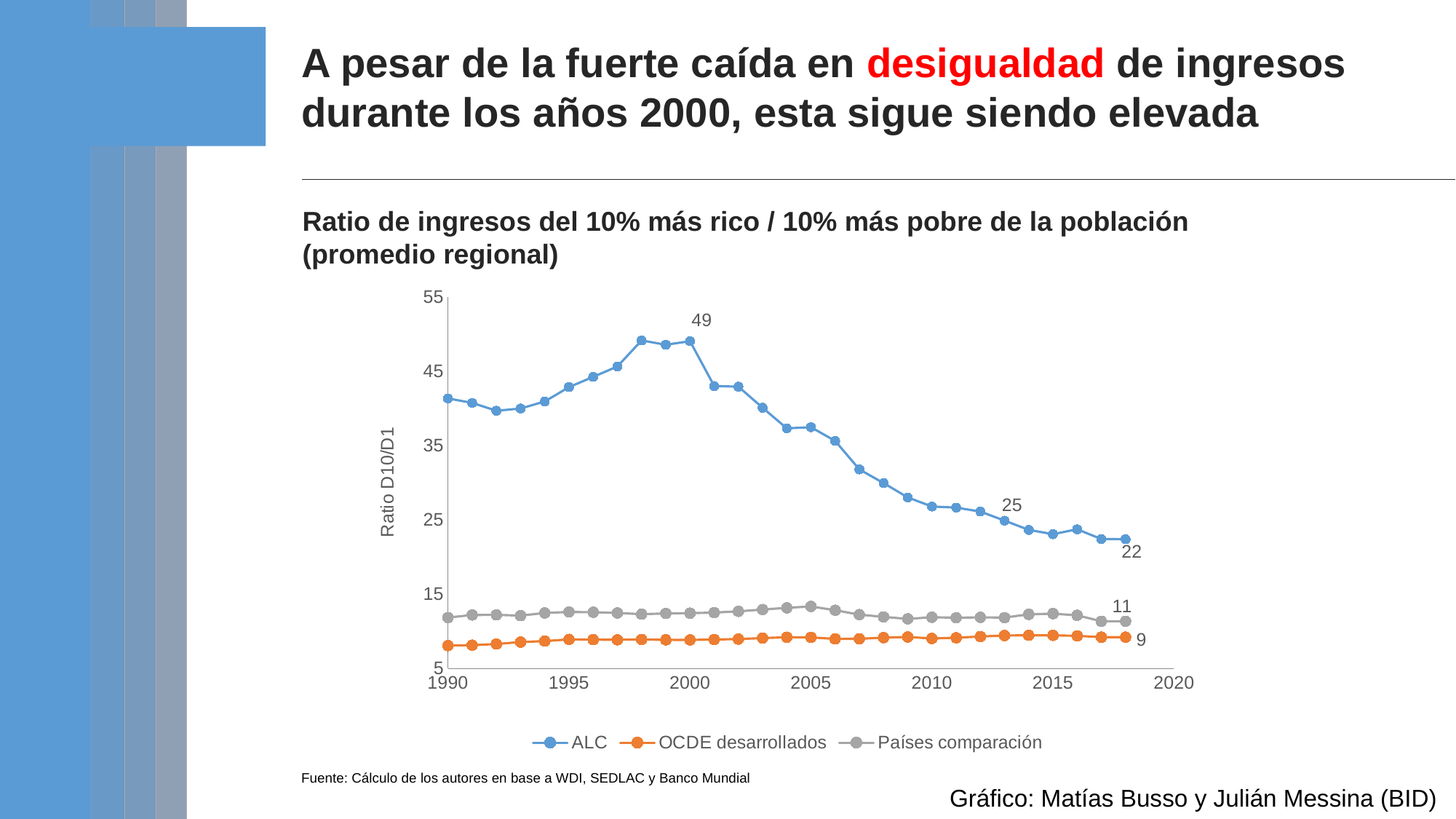
Which series has the highest values throughout the chart? ALC Is the value for ALC in 1990 greater or less than 35? greater What is the value of the OCDE desarrollados series in 2018? 9 What is the difference between the ALC value in 2000 and the ALC value in 2018? 27 What is the value of the Países comparación series in 2018? 11 What is the label of the y axis? Ratio D10/D1 Does the ALC series rise or fall between 2000 and 2018? fall Which series has the lowest values throughout the chart? OCDE desarrollados How many series does the legend list? 3 What kind of chart is shown on the slide? line chart What is the value of the ALC series in 2018? 22 What is the value of the ALC series in 2000? 49